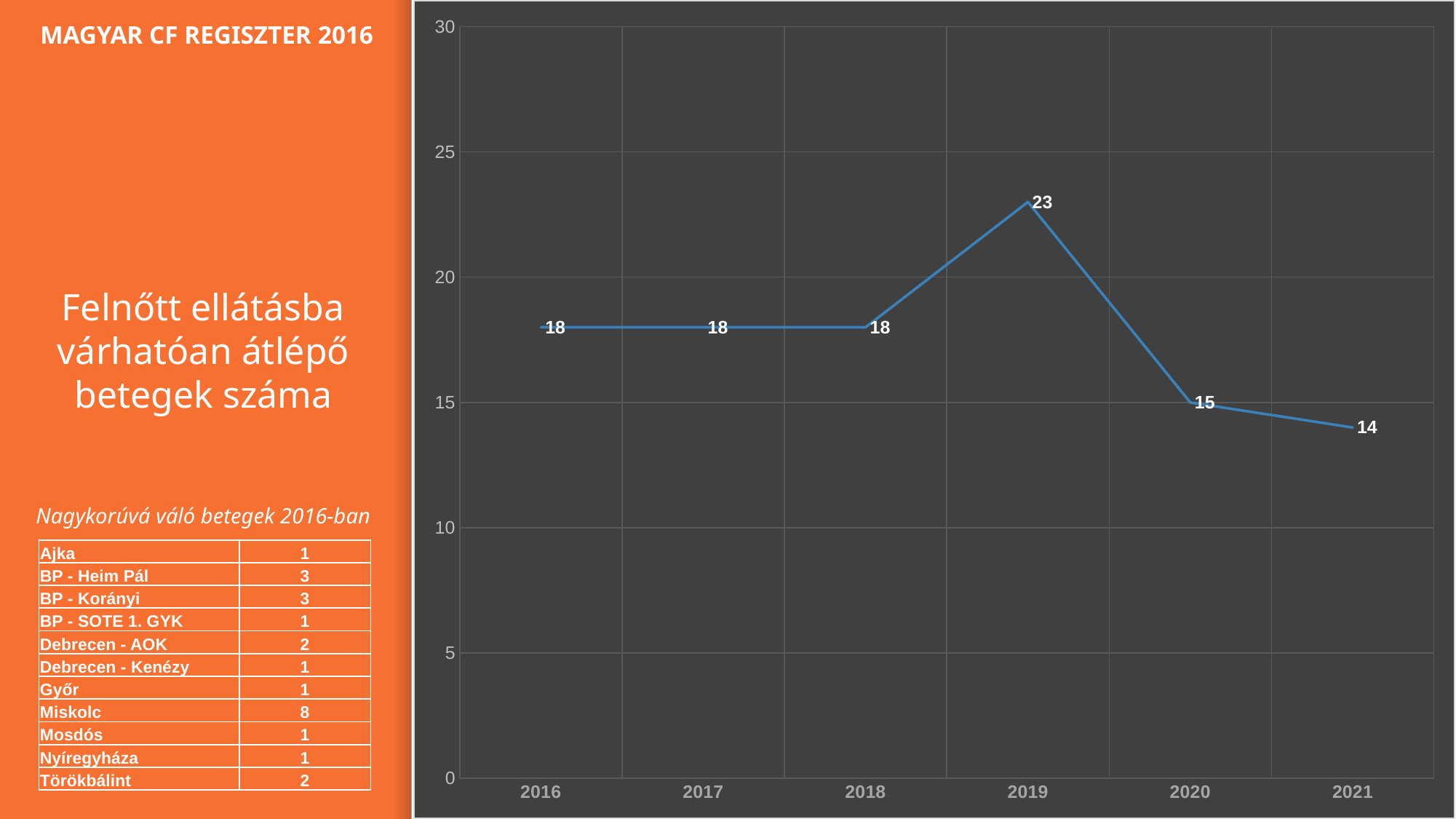
What is the value for 2021? 14 What is the difference between the values for 2020 and 2021? 1 What is the value for 2019? 23 Is the value for 2019 greater or less than 20? greater What is the value for 2016? 18 Which year has the highest value? 2019 Do the values rise or fall from 2019 to 2021? fall What kind of chart is shown? line chart Which year has the lowest value? 2021 Which is larger, the value for 2018 or the value for 2021? 2018 What is the difference between the values for 2019 and 2020? 8 How many years are plotted on the x axis? 6